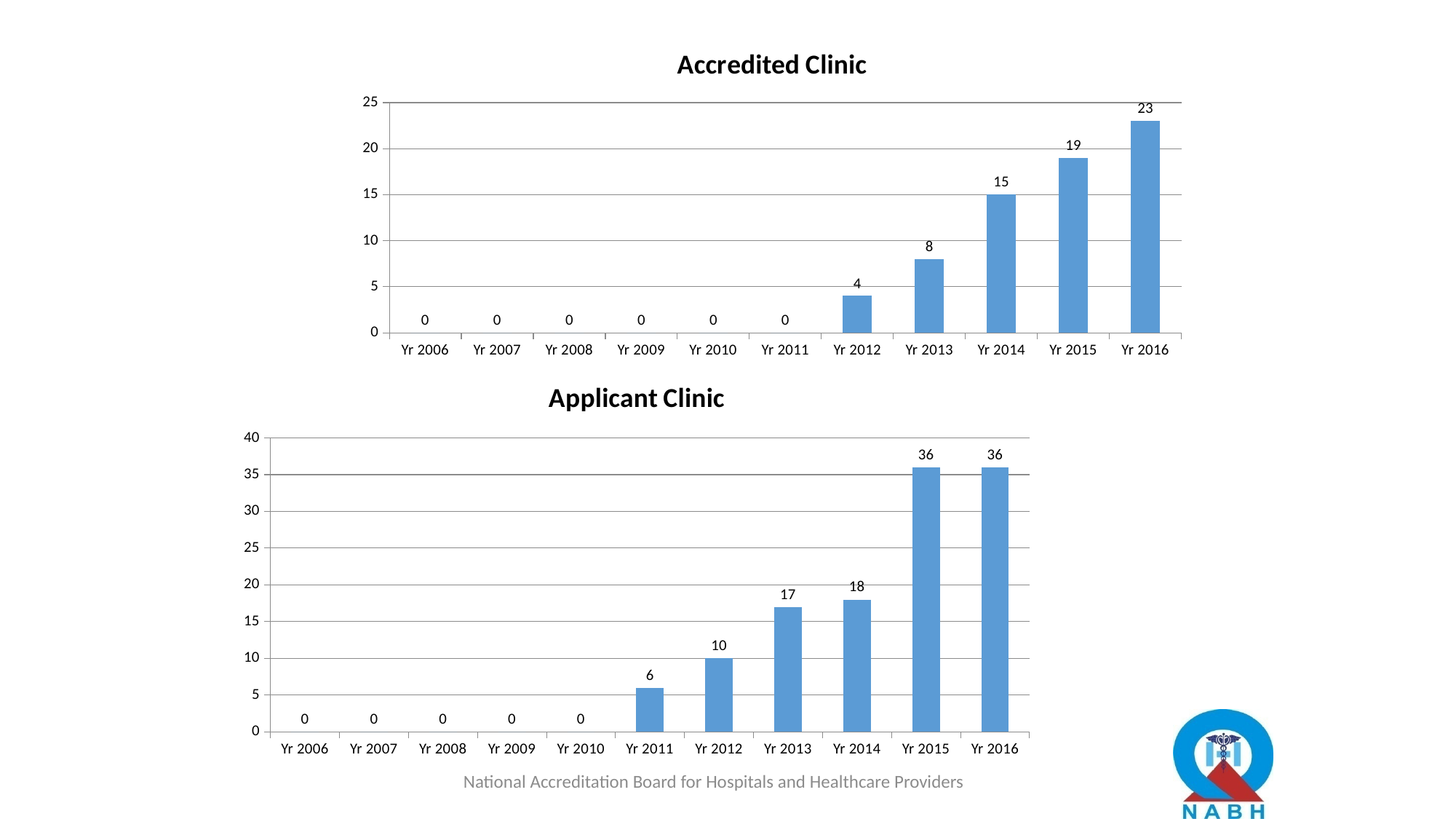
In the Applicant Clinic chart, which is the first year with a non-zero value? Yr 2011 In the Accredited Clinic chart, which year has the highest value? Yr 2016 In the Accredited Clinic chart, what is the value for Yr 2014? 15 In the Applicant Clinic chart, what is the difference between the values for Yr 2015 and Yr 2014? 18 In the Applicant Clinic chart, what is the value for Yr 2012? 10 What is the title of the lower chart on the slide? Applicant Clinic In the Accredited Clinic chart, what is the difference between the values for Yr 2016 and Yr 2013? 15 How many years are shown on the x axis of the Applicant Clinic chart? 11 In the Applicant Clinic chart, which is larger, the value for Yr 2013 or the value for Yr 2011? Yr 2013 In the Accredited Clinic chart, do the values rise or fall from Yr 2012 to Yr 2016? rise What kind of chart is the Accredited Clinic chart? bar chart In the Accredited Clinic chart, is the value for Yr 2015 greater or less than 15? greater